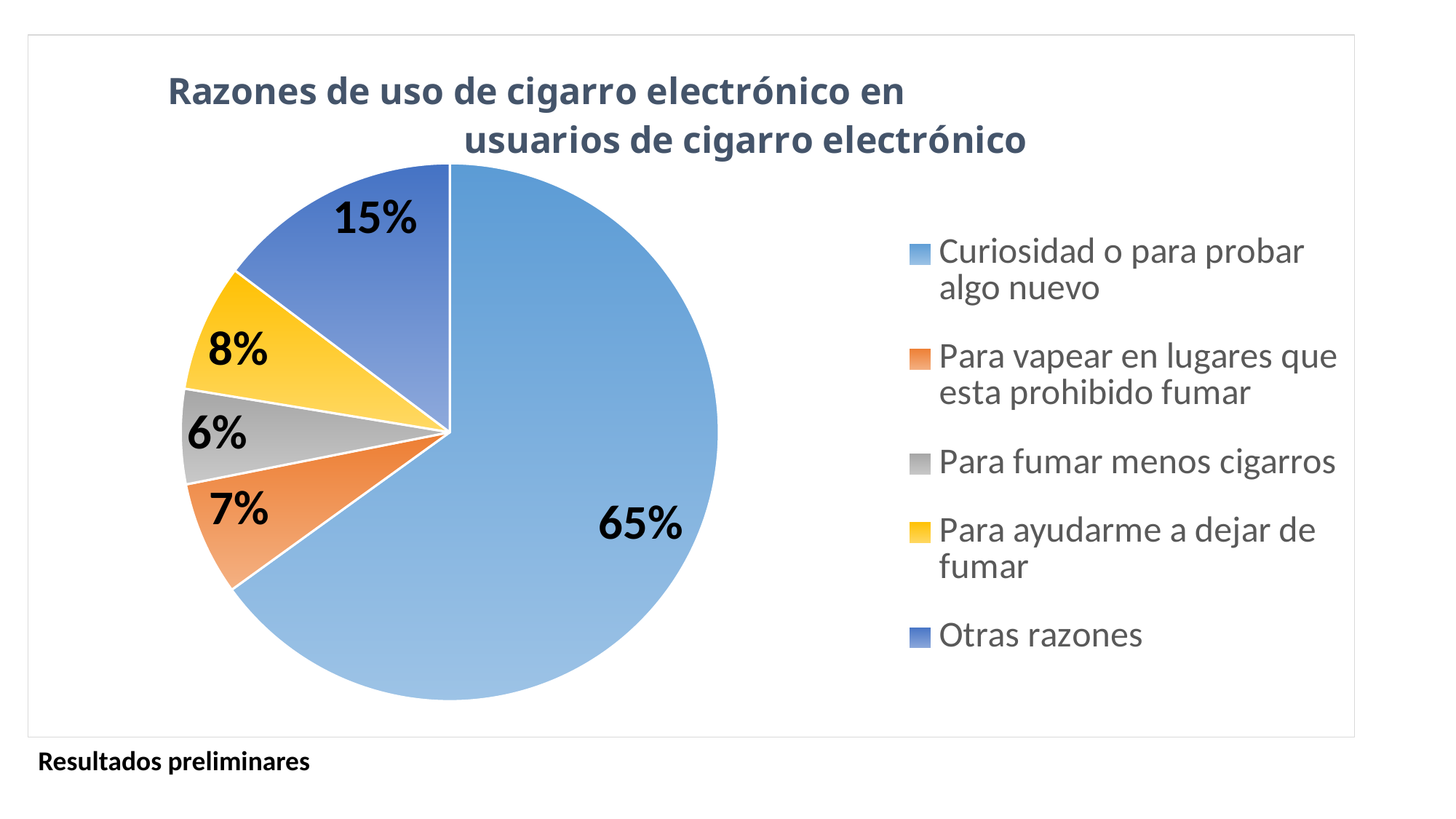
Which reason has the smallest share of the pie? Para fumar menos cigarros Which is larger: the share for 'Para ayudarme a dejar de fumar' or for 'Para vapear en lugares que esta prohibido fumar'? Para ayudarme a dejar de fumar How many slices does the pie chart have? 5 Which reason has the largest share of the pie? Curiosidad o para probar algo nuevo What percentage is shown for 'Para vapear en lugares que esta prohibido fumar'? 7% What kind of chart is shown on the slide? Pie chart What percentage is shown for 'Para fumar menos cigarros'? 6% What share of the pie is labelled 'Curiosidad o para probar algo nuevo'? 65% What percentage is shown for 'Para ayudarme a dejar de fumar'? 8% What is the title of the chart? Razones de uso de cigarro electrónico en usuarios de cigarro electrónico What is the difference in percentage points between 'Curiosidad o para probar algo nuevo' and 'Otras razones'? 50 What percentage is shown for 'Otras razones'? 15%